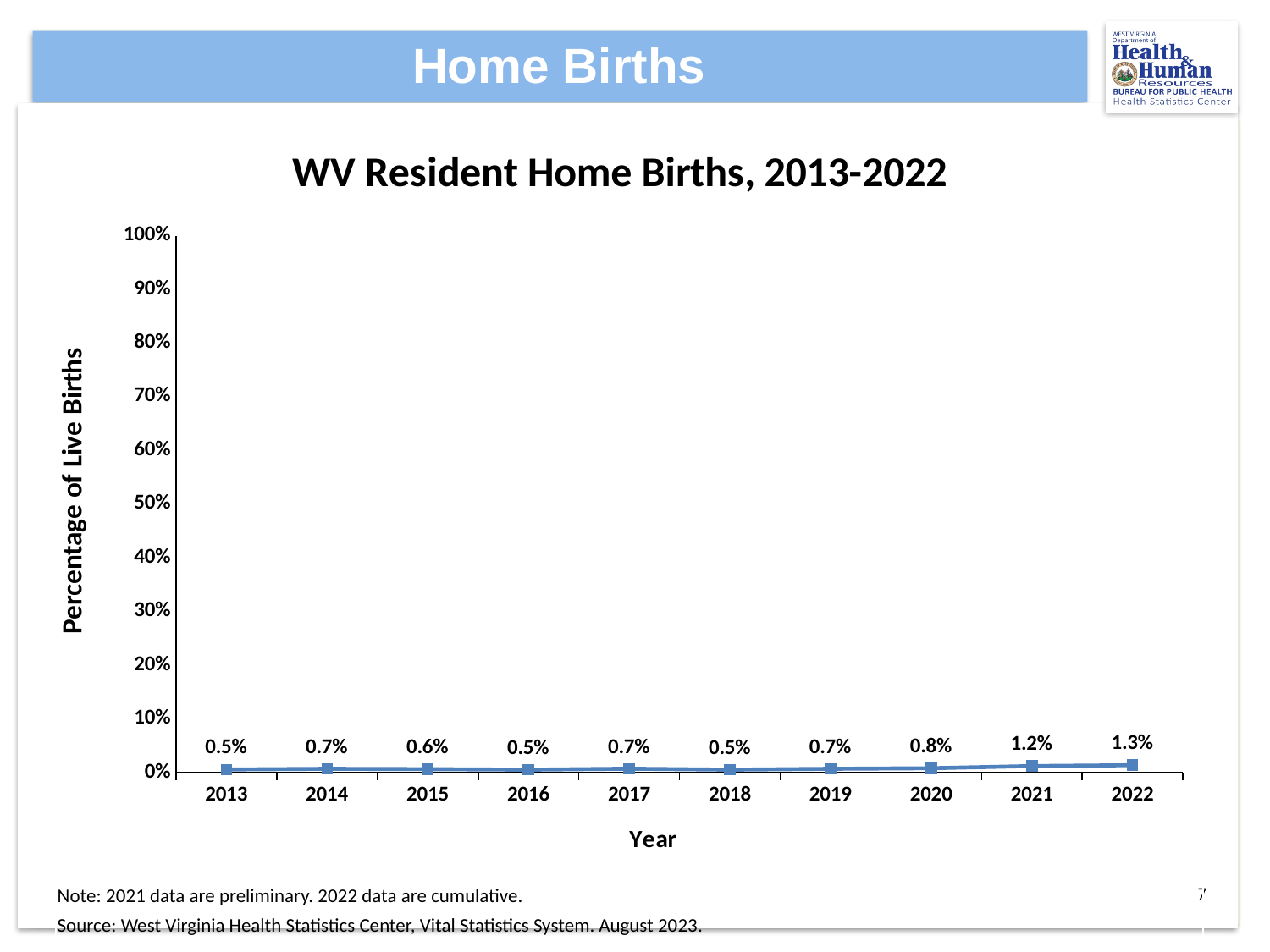
Which year has the highest percentage of home births? 2022 What is the value for 2013 on the WV Resident Home Births chart? 0.5% What is the title of the chart? WV Resident Home Births, 2013-2022 What is the percentage of live births that were home births in 2022? 1.3% What is the value for 2020? 0.8% How many years are plotted on the chart? 10 What kind of chart is shown on the slide? line chart Do the values generally rise or fall from 2019 to 2022? rise What is the difference between the 2022 value and the 2013 value? 0.8% Is the value for 2022 greater or less than 10%? less Which is larger, the value for 2021 or the value for 2019? 2021 What is the difference between the 2021 and 2020 values? 0.4%